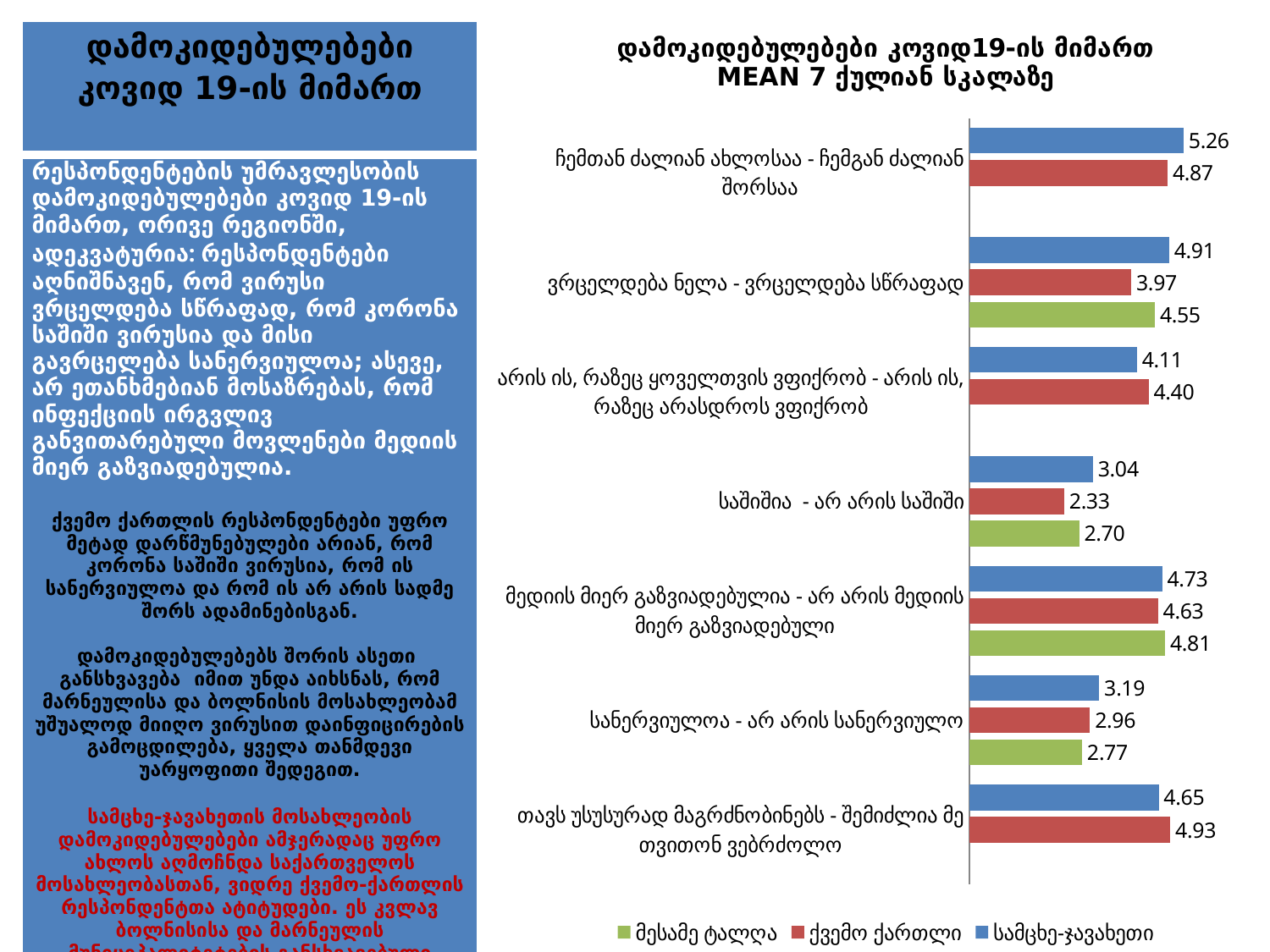
What is the value for ქვემო ქართლი in the category 'ვრცელდება ნელა - ვრცელდება სწრაფად'? 3.97 What is the value for მესამე ტალღა in the category 'მედიის მიერ გაზვიადებულია - არ არის მედიის მიერ გაზვიადებული'? 4.81 What is the value for სამცხე-ჯავახეთი in the category 'ჩემთან ძალიან ახლოსაა - ჩემგან ძალიან შორსაა'? 5.26 How many categories are shown on the chart? 7 What is the value for მესამე ტალღა in the category 'საშიშია - არ არის საშიში'? 2.70 What type of chart is shown on the slide? bar chart Which series is shown in green in the chart legend? მესამე ტალღა In the category 'თავს უსუსურად მაგრძნობინებს - შემიძლია მე თვითონ ვებრძოლო', which series has the larger value, სამცხე-ჯავახეთი or ქვემო ქართლი? ქვემო ქართლი How many series does the chart legend list? 3 Which category has the lowest value for ქვემო ქართლი? საშიშია - არ არის საშიში Which category has the highest value for სამცხე-ჯავახეთი? ჩემთან ძალიან ახლოსაა - ჩემგან ძალიან შორსაა What is the difference between the სამცხე-ჯავახეთი and ქვემო ქართლი values in the category 'ვრცელდება ნელა - ვრცელდება სწრაფად'? 0.94